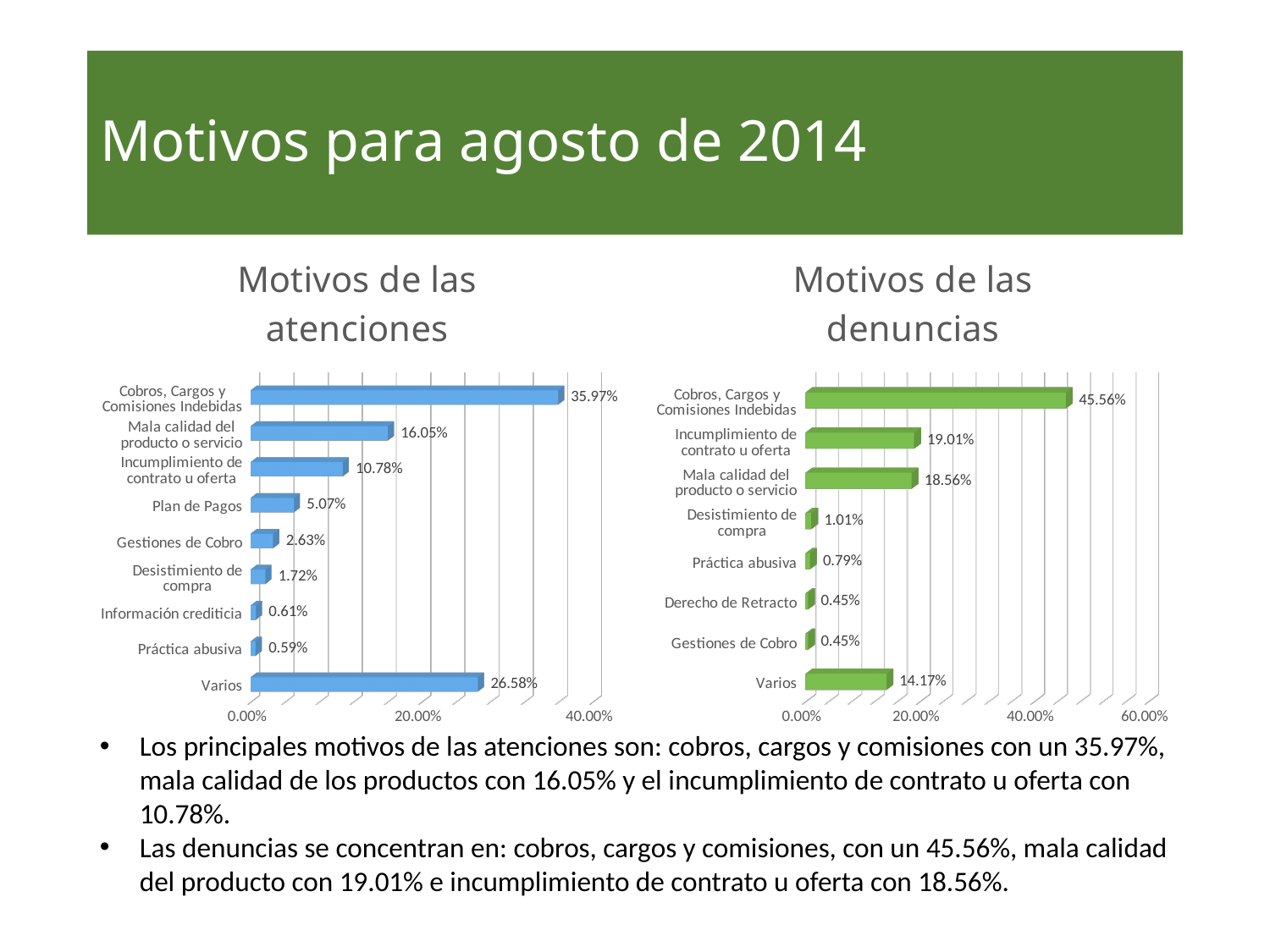
In the 'Motivos de las denuncias' chart, what is the value for Derecho de Retracto? 0.45% How many categories are shown in the 'Motivos de las denuncias' chart? 8 What kind of chart is 'Motivos de las denuncias'? Bar chart In the 'Motivos de las atenciones' chart, which is larger: Plan de Pagos or Gestiones de Cobro? Plan de Pagos In the 'Motivos de las atenciones' chart, which category has the highest value? Cobros, Cargos y Comisiones Indebidas In the 'Motivos de las atenciones' chart, what is the value for Mala calidad del producto o servicio? 16.05% In the 'Motivos de las atenciones' chart, what is the difference between Cobros, Cargos y Comisiones Indebidas and Varios? 9.39% In the 'Motivos de las atenciones' chart, what is the value for Varios? 26.58% In the 'Motivos de las denuncias' chart, what is the value for Incumplimiento de contrato u oferta? 19.01% In the 'Motivos de las denuncias' chart, what is the difference between Cobros, Cargos y Comisiones Indebidas and Incumplimiento de contrato u oferta? 26.55% How many categories are shown in the 'Motivos de las atenciones' chart? 9 In the 'Motivos de las denuncias' chart, which category has the highest value? Cobros, Cargos y Comisiones Indebidas